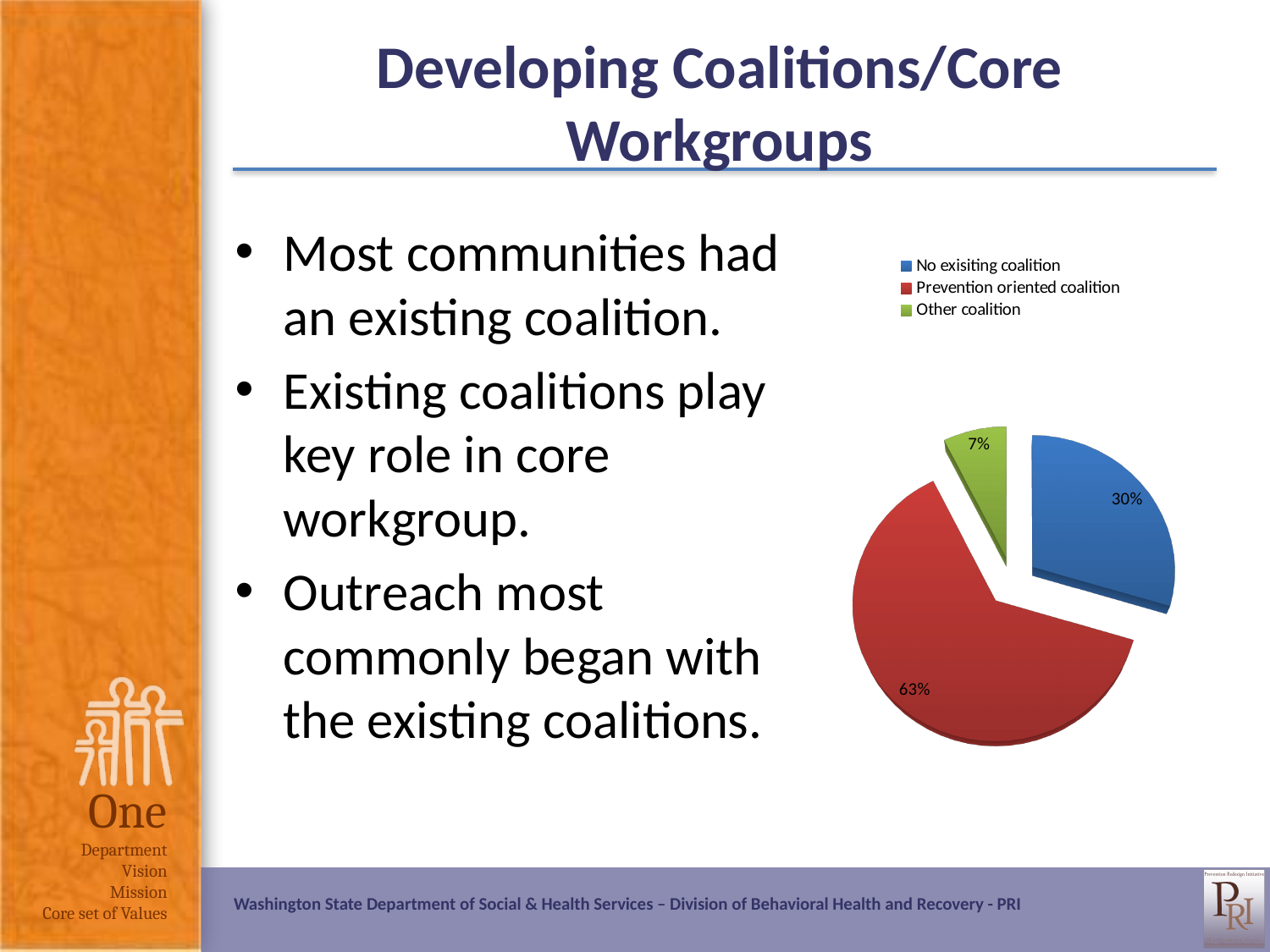
How many entries does the legend list? 3 What percentage of the pie is labelled for the 'Prevention oriented coalition' slice? 63% What colour is the 'Prevention oriented coalition' slice? Red Which is larger: the 'No exisiting coalition' slice or the 'Other coalition' slice? No exisiting coalition What kind of chart is shown on the slide? Pie chart How many slices does the pie chart have? 3 What percentage of the pie is labelled for the 'No exisiting coalition' slice? 30% Which category has the largest share of the pie? Prevention oriented coalition What percentage of the pie is labelled for the 'Other coalition' slice? 7% What colour is the 'Other coalition' slice? Green Which category has the smallest share of the pie? Other coalition What is the difference in percentage points between the 'Prevention oriented coalition' slice and the 'No exisiting coalition' slice? 33